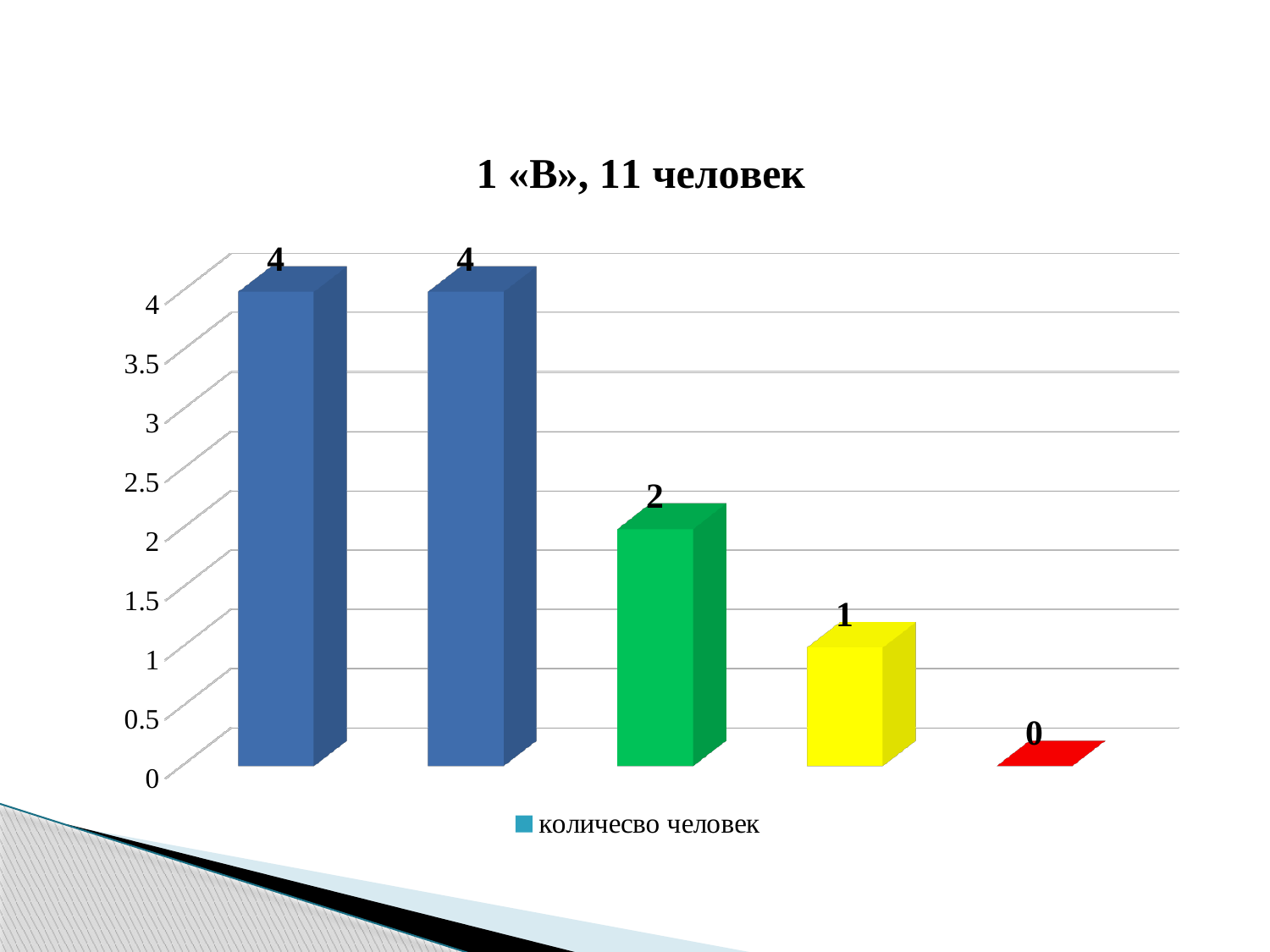
What is the value of the green bar? 2 What is the value of the first (leftmost) bar? 4 What is the value of the yellow bar? 1 What is the value of the red bar (rightmost)? 0 What type of chart is shown on the slide? bar chart What is the difference between the value of the green bar and the value of the yellow bar? 1 How many series does the legend list? 1 What is the legend entry shown below the chart? количесво человек How many bars are plotted in the chart? 5 Do the bar values rise or fall from left to right across the chart? fall Which bar has the lowest value? the red (rightmost) bar What is the title of the chart? 1 «В», 11 человек